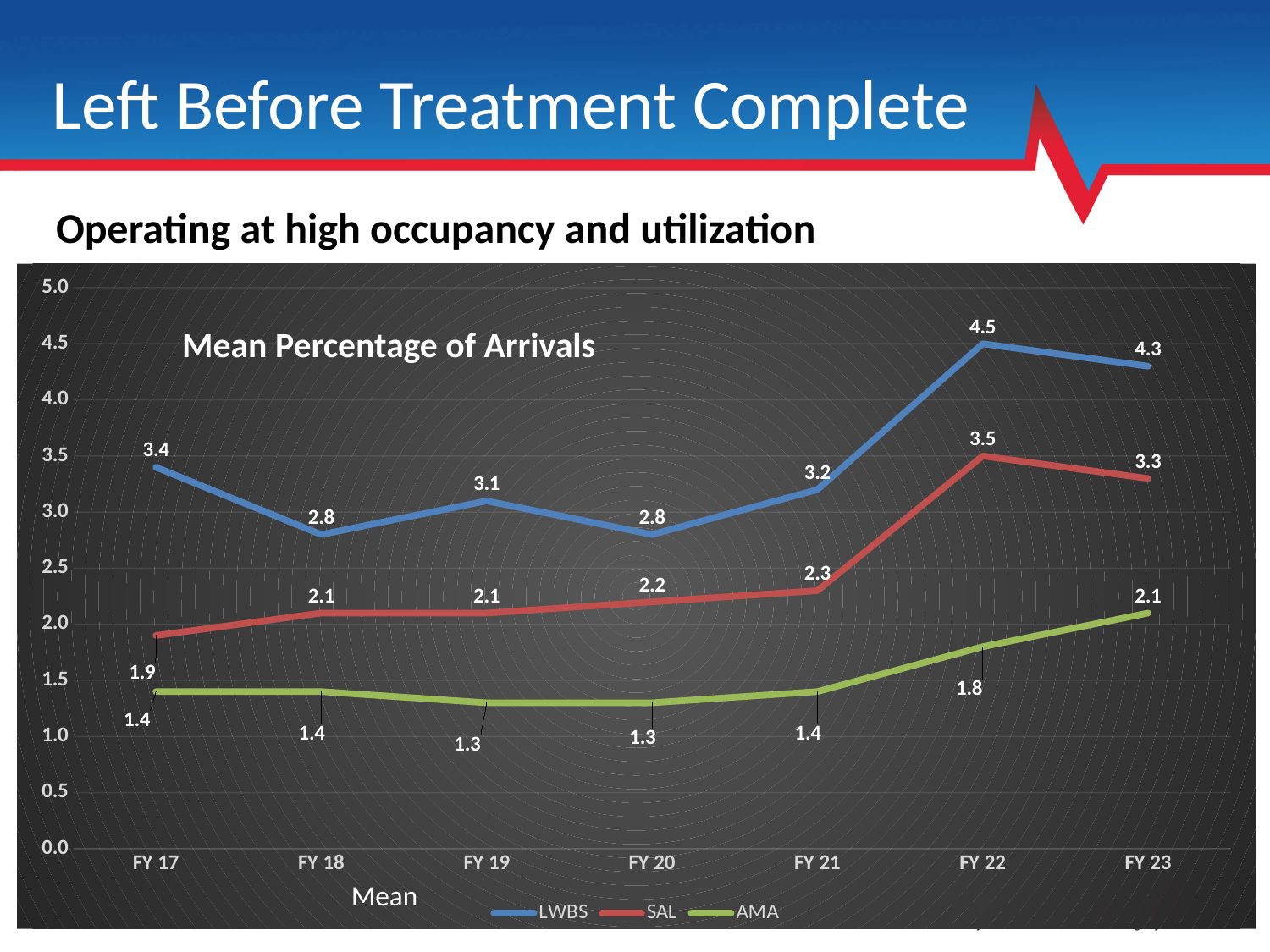
What is the LWBS value for FY 22? 4.5 What type of chart is shown on the slide? line chart What is the AMA value for FY 23? 2.1 Which is larger, the SAL value in FY 22 or the LWBS value in FY 20? SAL value in FY 22 What is the title shown inside the chart area? Mean Percentage of Arrivals How many fiscal years are plotted on the x axis? 7 In which fiscal year is the SAL value lowest? FY 17 What is the difference between the LWBS value in FY 22 and the LWBS value in FY 17? 1.1 Does the AMA series rise or fall from FY 21 to FY 23? rise In which fiscal year is the LWBS value highest? FY 22 How many series does the legend list? 3 What is the SAL value for FY 17? 1.9